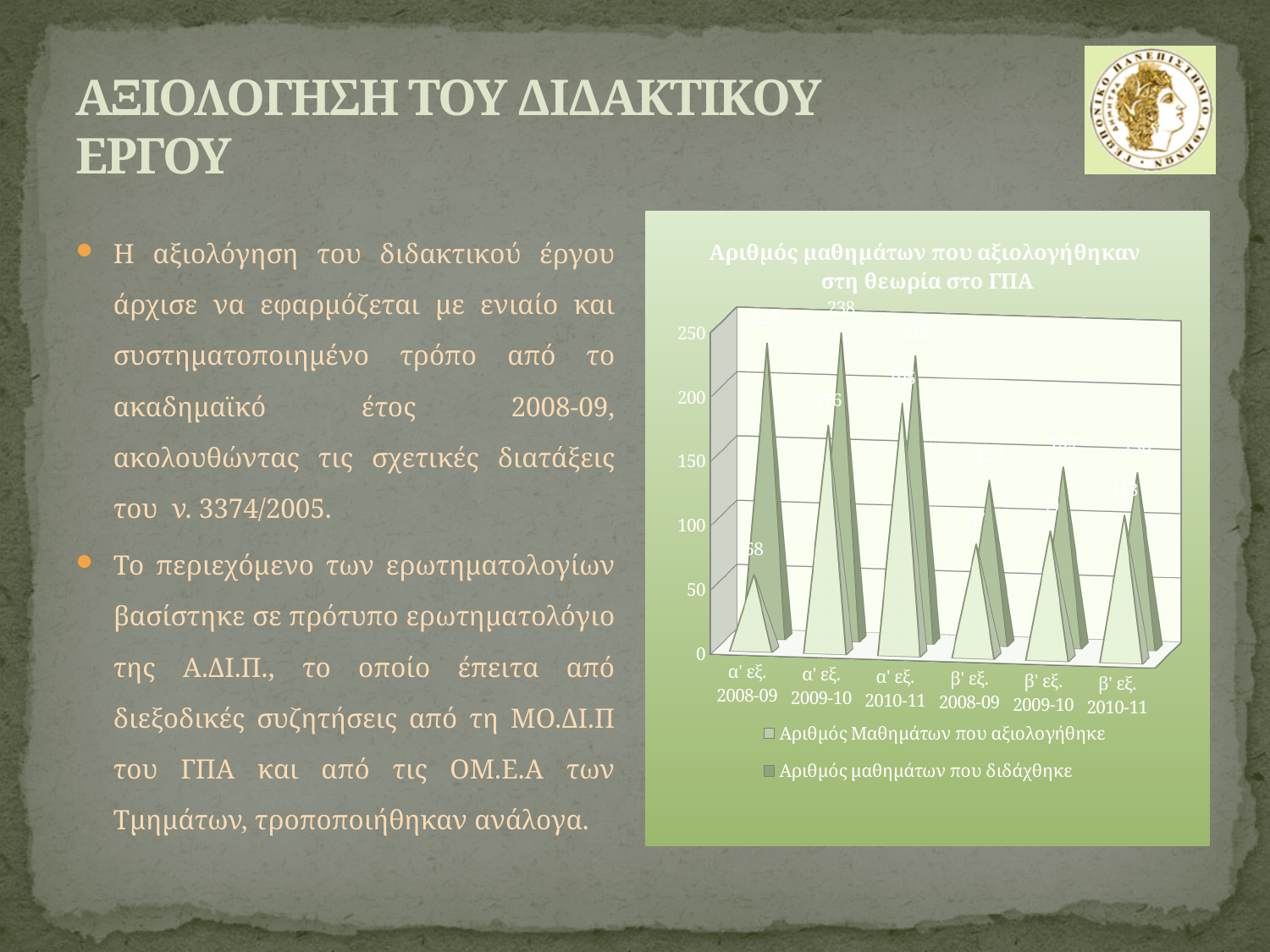
How many series does the chart legend list? 2 What are the two series named in the chart legend? Αριθμός Μαθημάτων που αξιολογήθηκε; Αριθμός μαθημάτων που διδάχθηκε What is the value of 'Αριθμός Μαθημάτων που αξιολογήθηκε' for α' εξ. 2008-09? 58 What is the title of the chart? Αριθμός μαθημάτων που αξιολογήθηκαν στη θεωρία στο ΓΠΑ For α' εξ. 2008-09, which series has the larger value: 'Αριθμός Μαθημάτων που αξιολογήθηκε' or 'Αριθμός μαθημάτων που διδάχθηκε'? Αριθμός μαθημάτων που διδάχθηκε Is the value of 'Αριθμός μαθημάτων που διδάχθηκε' for α' εξ. 2008-09 greater or less than 200? greater Is the value of 'Αριθμός Μαθημάτων που αξιολογήθηκε' for α' εξ. 2008-09 greater or less than 100? less Is the value of 'Αριθμός Μαθημάτων που αξιολογήθηκε' for β' εξ. 2008-09 greater or less than 150? less How many categories are shown along the x axis of the chart? 6 What is the value of 'Αριθμός μαθημάτων που διδάχθηκε' for α' εξ. 2009-10? 238 Which category has the lowest value for 'Αριθμός Μαθημάτων που αξιολογήθηκε'? α' εξ. 2008-09 What kind of chart is shown on the slide? bar chart